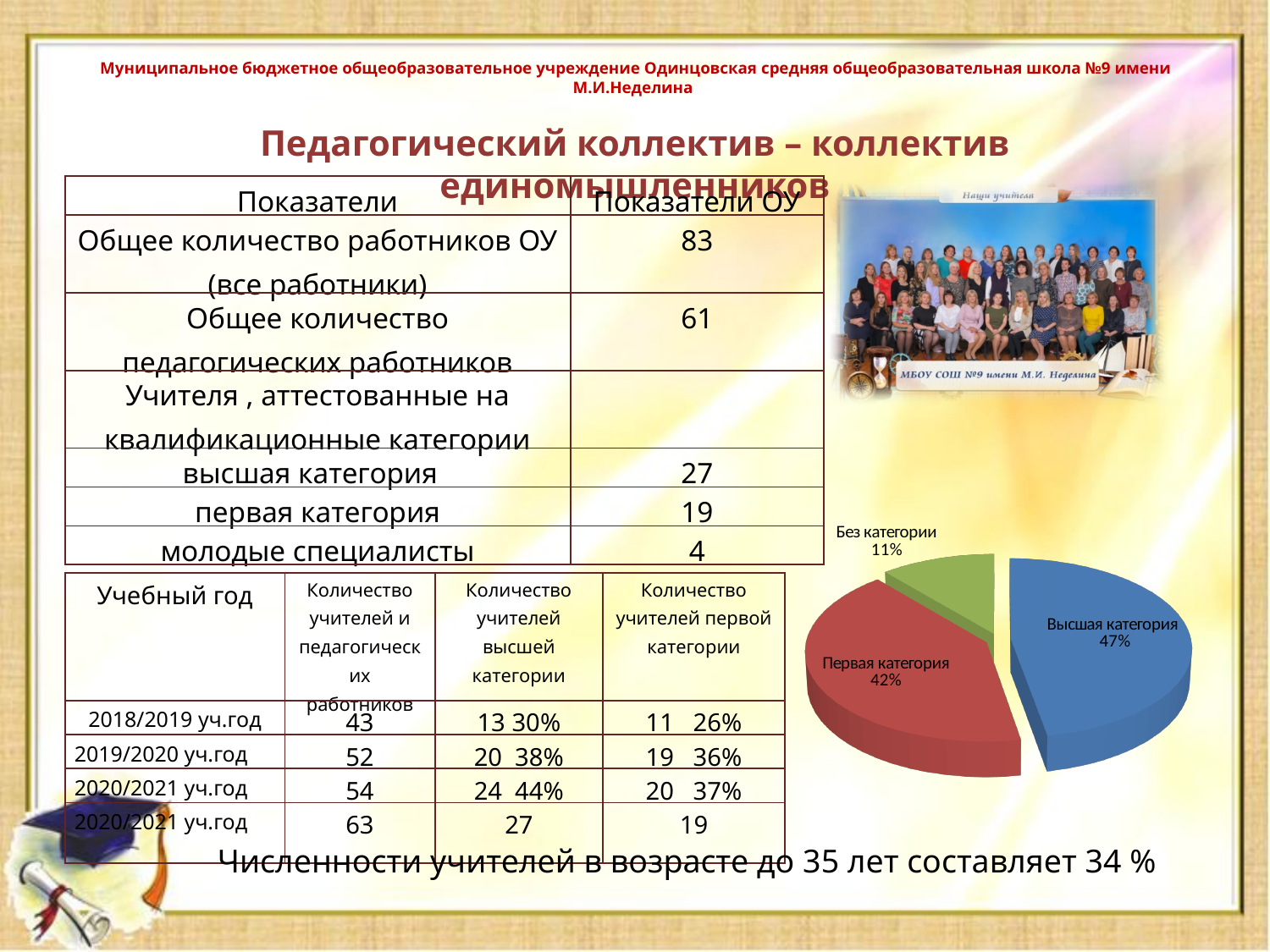
What colour is the "Без категории" slice in the pie chart? green In the pie chart, what is the difference in percentage points between "Высшая категория" and "Первая категория"? 5 How many slices does the pie chart have? 3 In the pie chart, which is larger: "Первая категория" or "Без категории"? Первая категория Which slice of the pie chart is the largest? Высшая категория In the pie chart, what is the difference in percentage points between "Первая категория" and "Без категории"? 31 What share of the pie chart is labelled "Без категории"? 11% What share of the pie chart is labelled "Высшая категория"? 47% What colour is the "Высшая категория" slice in the pie chart? blue Which slice of the pie chart is the smallest? Без категории What type of chart is shown on the slide? pie chart What share of the pie chart is labelled "Первая категория"? 42%